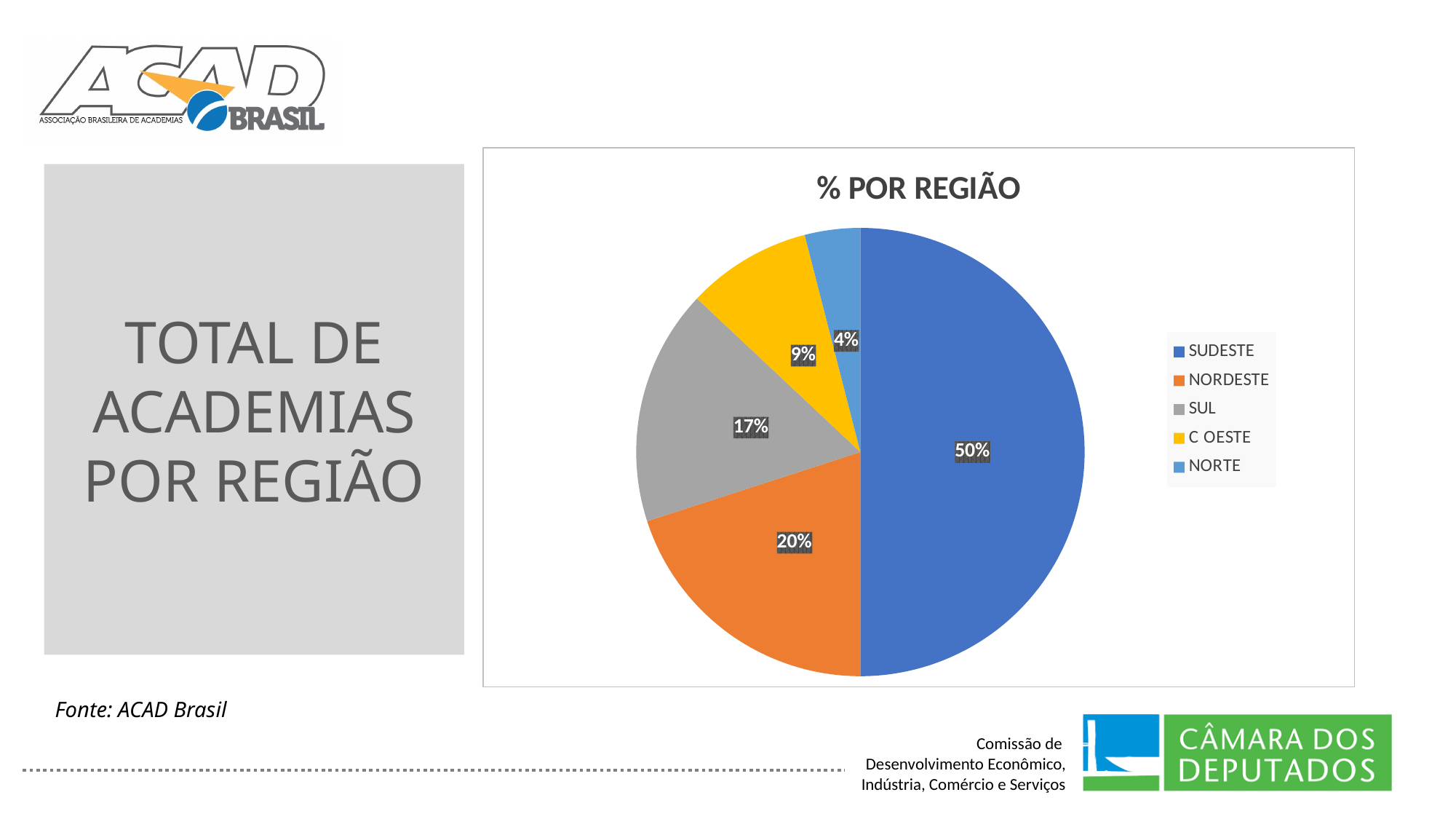
What is the title of the chart? % POR REGIÃO What percentage does the NORDESTE slice show? 20% What percentage does the NORTE slice show? 4% Which region has the largest share of the pie? SUDESTE Which region has the smallest share of the pie? NORTE What percentage does the SUL slice show? 17% What is the difference in percentage points between SUDESTE and NORDESTE? 30 Which has a larger share, SUL or C OESTE? SUL What type of chart is shown on the slide? pie chart How many regions are listed in the legend? 5 What percentage does the SUDESTE slice show? 50% What percentage does the C OESTE slice show? 9%